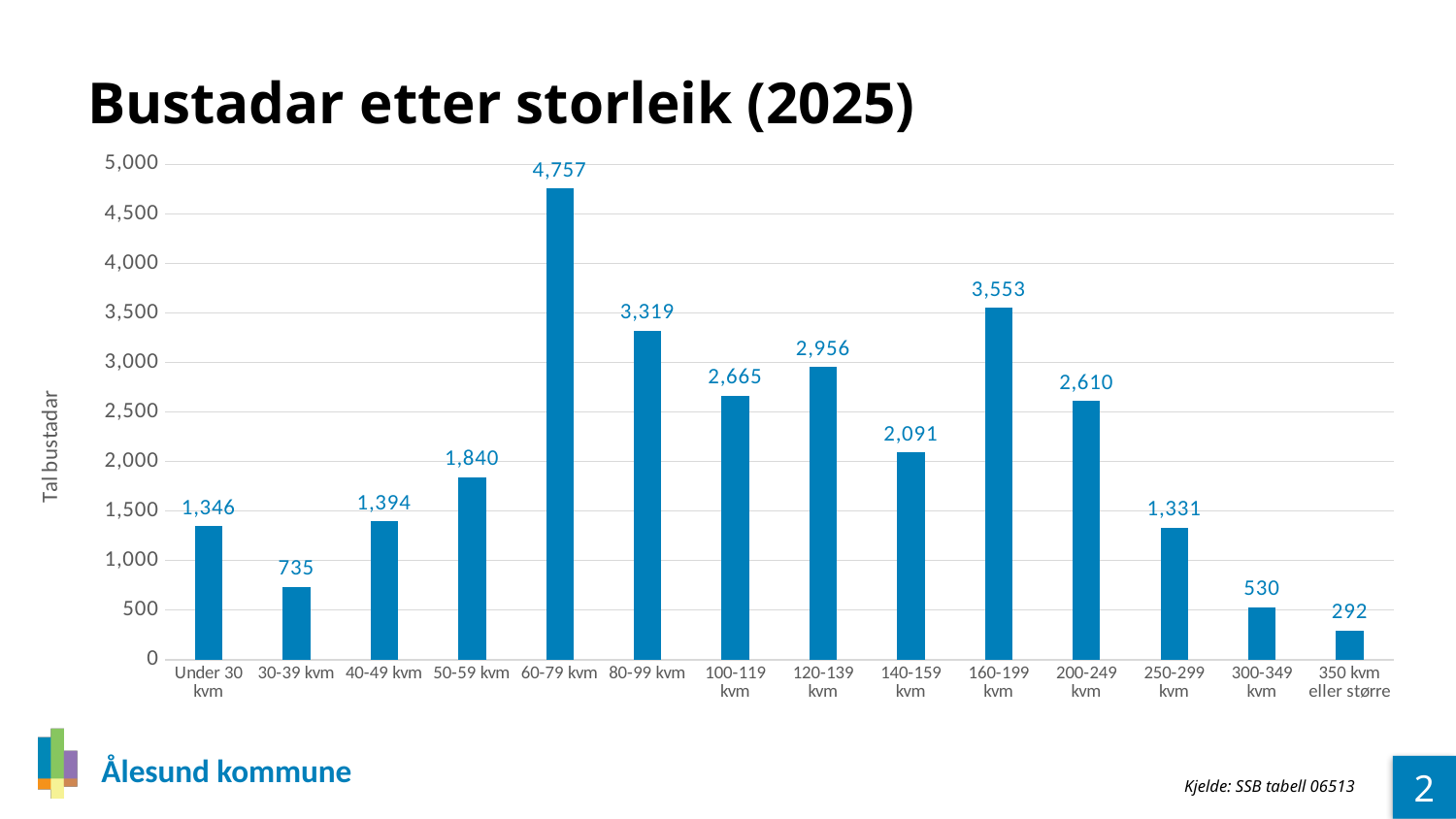
What is the value for 160-199 kvm? 3,553 How many size categories are shown on the x axis? 14 Which size category has the lowest number of dwellings? 350 kvm eller større What is the label on the vertical axis? Tal bustadar What is the difference between the values for 300-349 kvm and 350 kvm eller større? 238 What is the value for 350 kvm eller større? 292 Which size category has the highest number of dwellings? 60-79 kvm What kind of chart is shown on the slide? bar chart What is the difference between the values for 60-79 kvm and 160-199 kvm? 1,204 What is the value for 60-79 kvm? 4,757 Is the value for 80-99 kvm greater or less than 3,000? greater Which is larger, the value for 120-139 kvm or the value for 100-119 kvm? 120-139 kvm